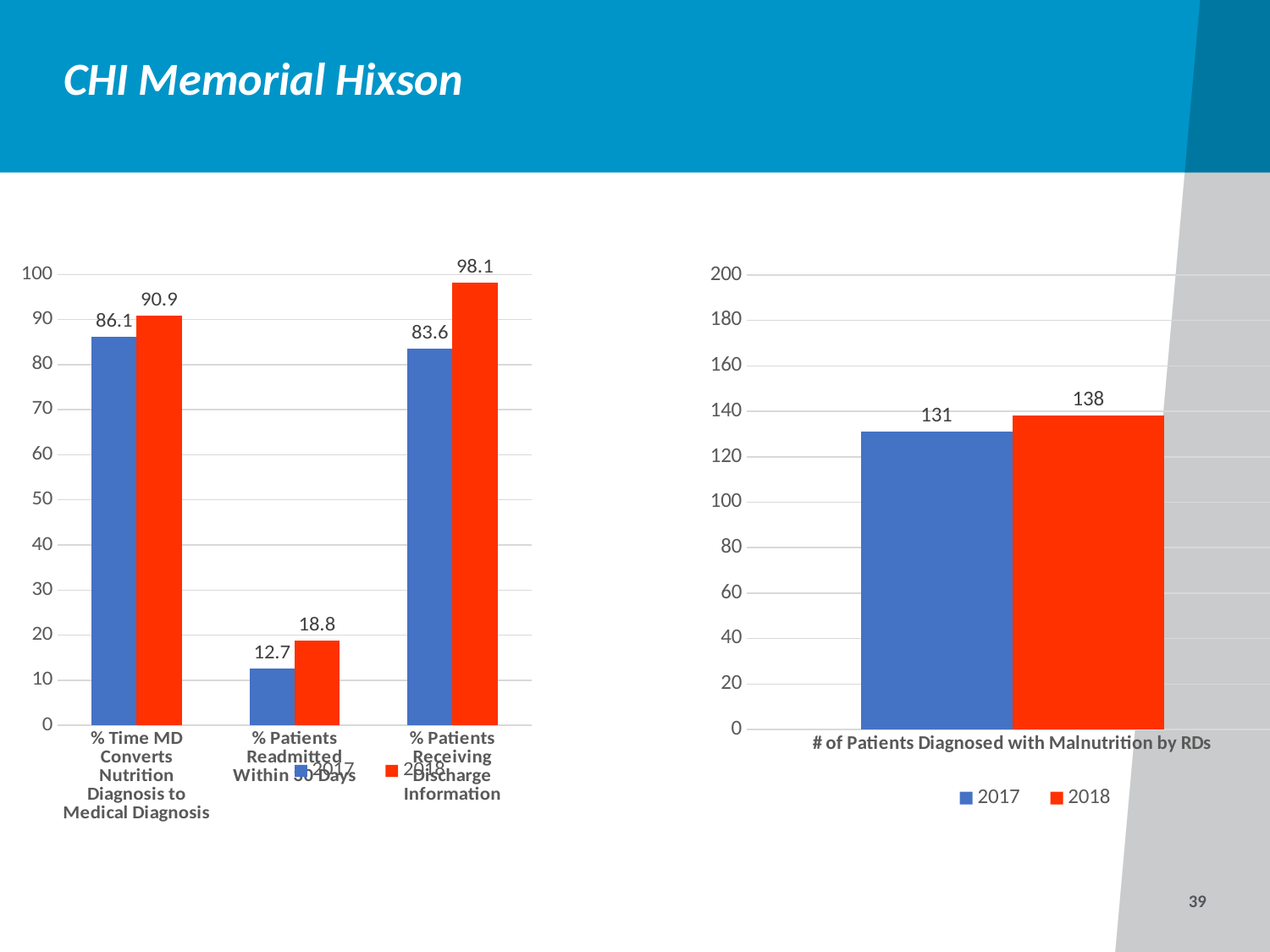
How many series does the legend of the right chart list? 2 In the left chart, which category has the highest 2018 value? % Patients Receiving Discharge Information In the left chart, which category has the lowest 2017 value? % Patients Readmitted Within 30 Days In the right chart, what is the 2018 value for # of Patients Diagnosed with Malnutrition by RDs? 138 In the left chart, what is the 2018 value for % Patients Readmitted Within 30 Days? 18.8 In the left chart, what is the 2017 value for % Time MD Converts Nutrition Diagnosis to Medical Diagnosis? 86.1 In the right chart, what is the difference between the 2018 and 2017 values? 7 In the left chart, what is the difference between the 2018 and 2017 values for % Patients Receiving Discharge Information? 14.5 In the right chart, what is the 2017 value for # of Patients Diagnosed with Malnutrition by RDs? 131 In the left chart, which is larger for % Time MD Converts Nutrition Diagnosis to Medical Diagnosis: the 2017 value or the 2018 value? 2018 In the left chart, what is the 2018 value for % Patients Receiving Discharge Information? 98.1 How many categories are shown on the x axis of the left chart? 3